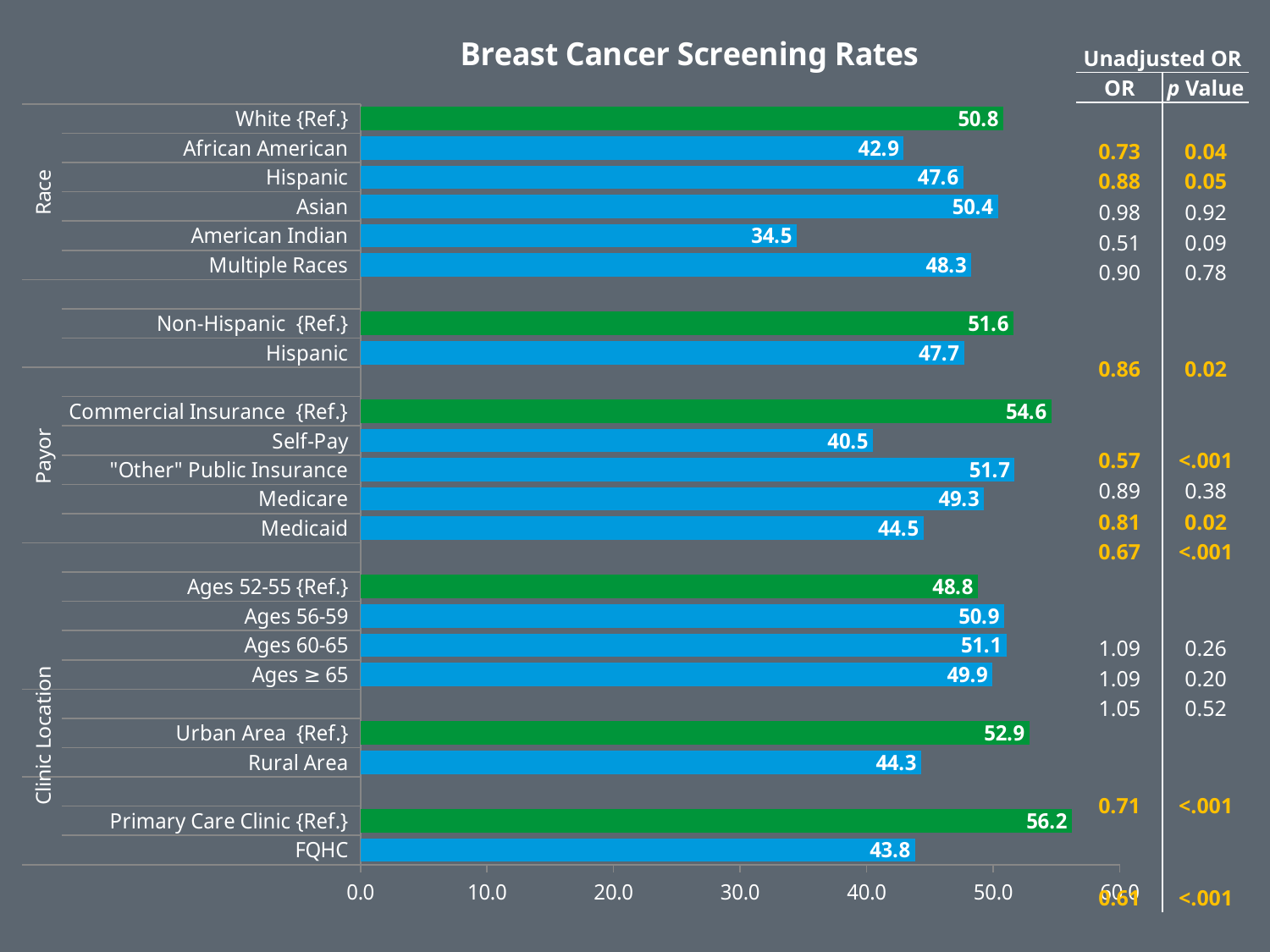
What is the breast cancer screening rate for American Indian patients? 34.5 What is the screening rate shown for the Self-Pay category? 40.5 What is the screening rate for the Rural Area category? 44.3 What type of chart is used to show the screening rates? bar chart How many bars are plotted on the chart? 21 Which has a higher screening rate, Medicare or Multiple Races? Medicare Which category has the highest screening rate on the chart? Primary Care Clinic {Ref.} Is the screening rate for FQHC greater or less than 50.0? less Which category has the lowest screening rate on the chart? American Indian What is the title of the chart? Breast Cancer Screening Rates What is the difference between the screening rates for Commercial Insurance {Ref.} and Medicaid? 10.1 How much higher is the screening rate for Urban Area {Ref.} than for Rural Area? 8.6